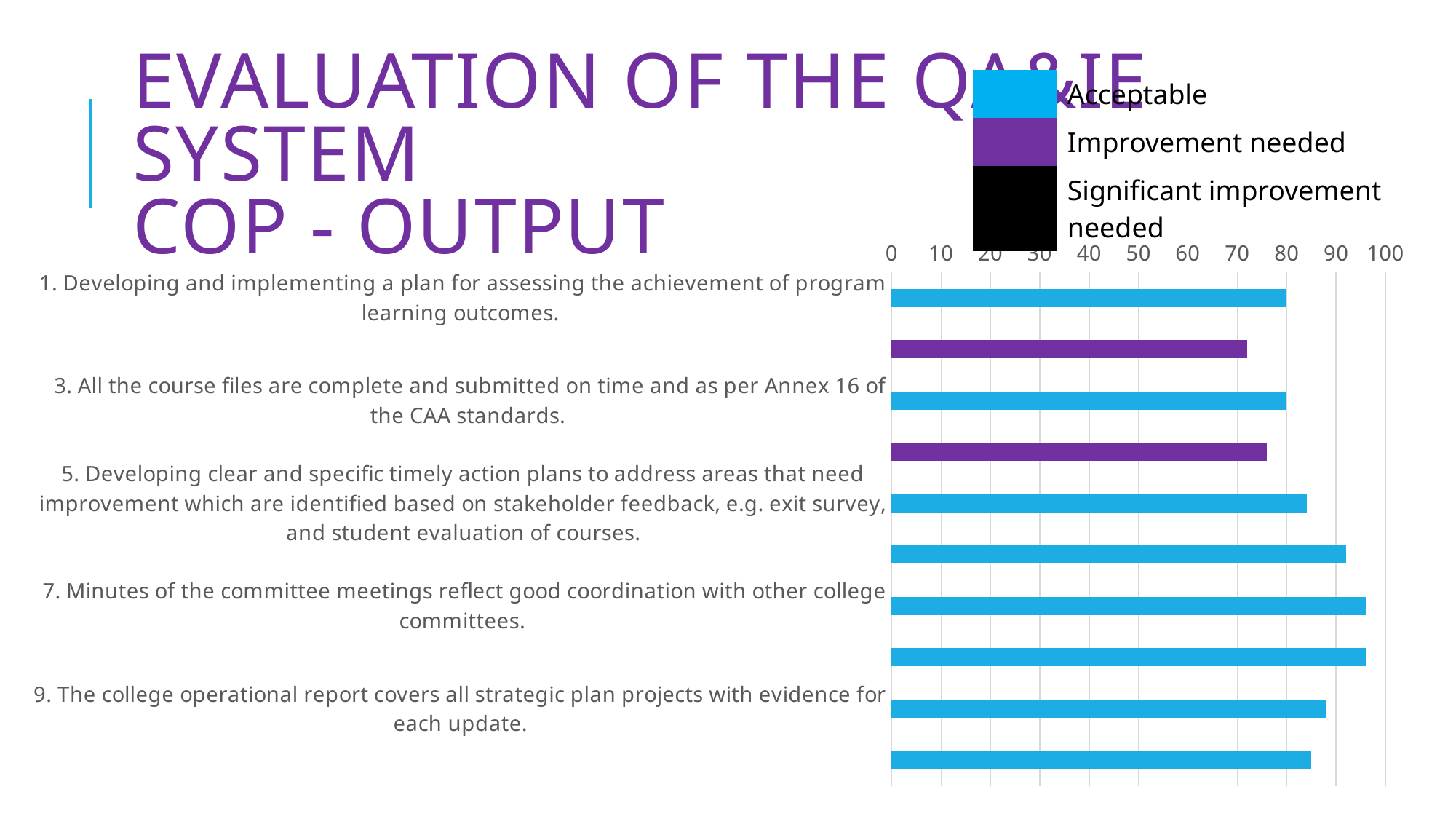
Is the value for item 9 (The college operational report covers all strategic plan projects with evidence for each update) greater or less than 80? greater Is the value for item 1 (Developing and implementing a plan for assessing the achievement of program learning outcomes) greater or less than 90? less Among the labelled items, which has the longest bar? 7. Minutes of the committee meetings reflect good coordination with other college committees. How many bars are plotted in the chart? 10 Is the value for item 7 (Minutes of the committee meetings reflect good coordination with other college committees) greater or less than 90? greater What kind of chart is shown on the slide? bar chart How many bars are coloured purple (Improvement needed)? 2 Which has the larger value: item 7 (Minutes of the committee meetings) or item 1 (Developing and implementing a plan for assessing program learning outcomes)? item 7 According to the legend, what rating do the blue bars represent? Acceptable How many entries does the chart legend list? 3 Which has the larger value: item 9 (The college operational report) or item 3 (All the course files are complete and submitted on time)? item 9